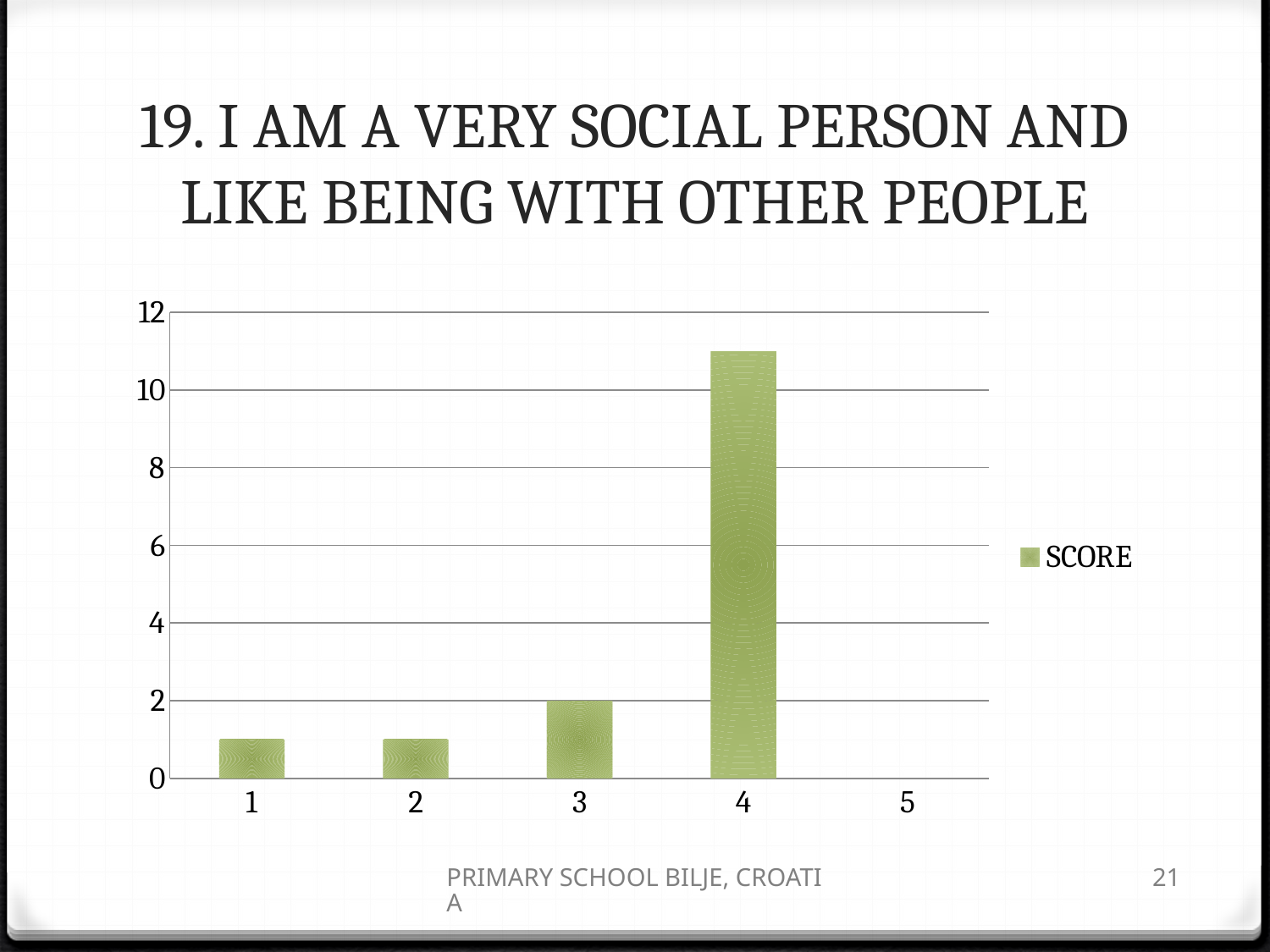
How many series does the legend list? 1 Which is larger, the value for category 3 or the value for category 1? 3 Is the value for category 1 greater or less than 2? less What kind of chart is shown on the slide? bar chart Is the value for category 4 greater or less than 10? greater Which category has the highest bar? 4 Do the values rise or fall from category 3 to category 4? rise Which is larger, the value for category 4 or the value for category 3? 4 What is the value for category 3? 2 How many categories are shown on the x axis? 5 What is the name of the series shown in the legend? SCORE Which category has the lowest value? 5